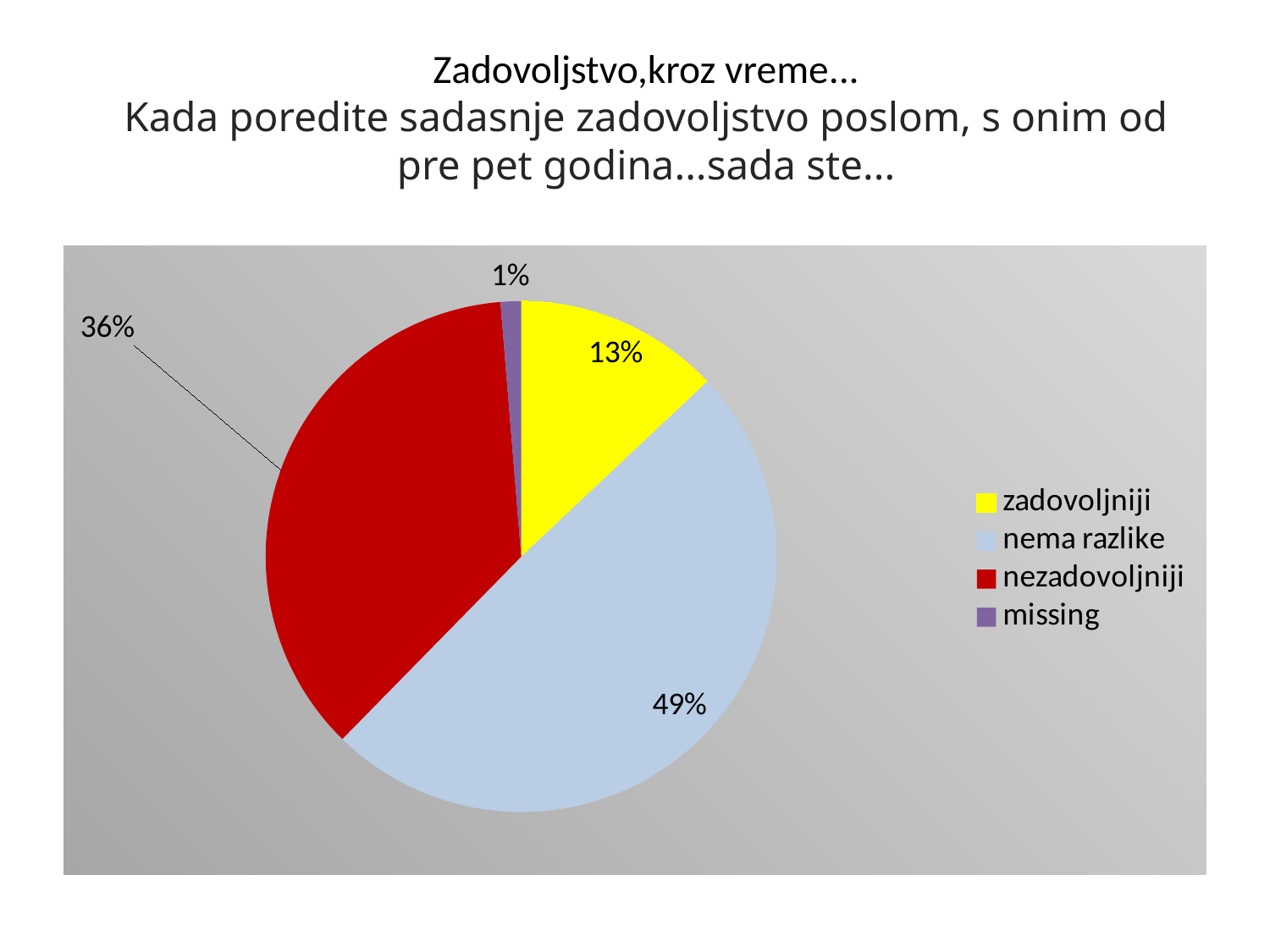
Which legend entry is shown in yellow? zadovoljniji How many slices does the pie chart have? 4 What percentage of the pie is the 'nema razlike' slice? 49% What percentage of the pie is the 'zadovoljniji' slice? 13% What is the difference in percentage points between 'nema razlike' and 'nezadovoljniji'? 13 What percentage of the pie is the 'missing' slice? 1% What percentage of the pie is the 'nezadovoljniji' slice? 36% What colour is the 'nezadovoljniji' slice? red Which category has the largest share of the pie? nema razlike What kind of chart is shown on the slide? pie chart Which is larger, the 'zadovoljniji' slice or the 'nezadovoljniji' slice? nezadovoljniji Which category has the smallest share of the pie? missing